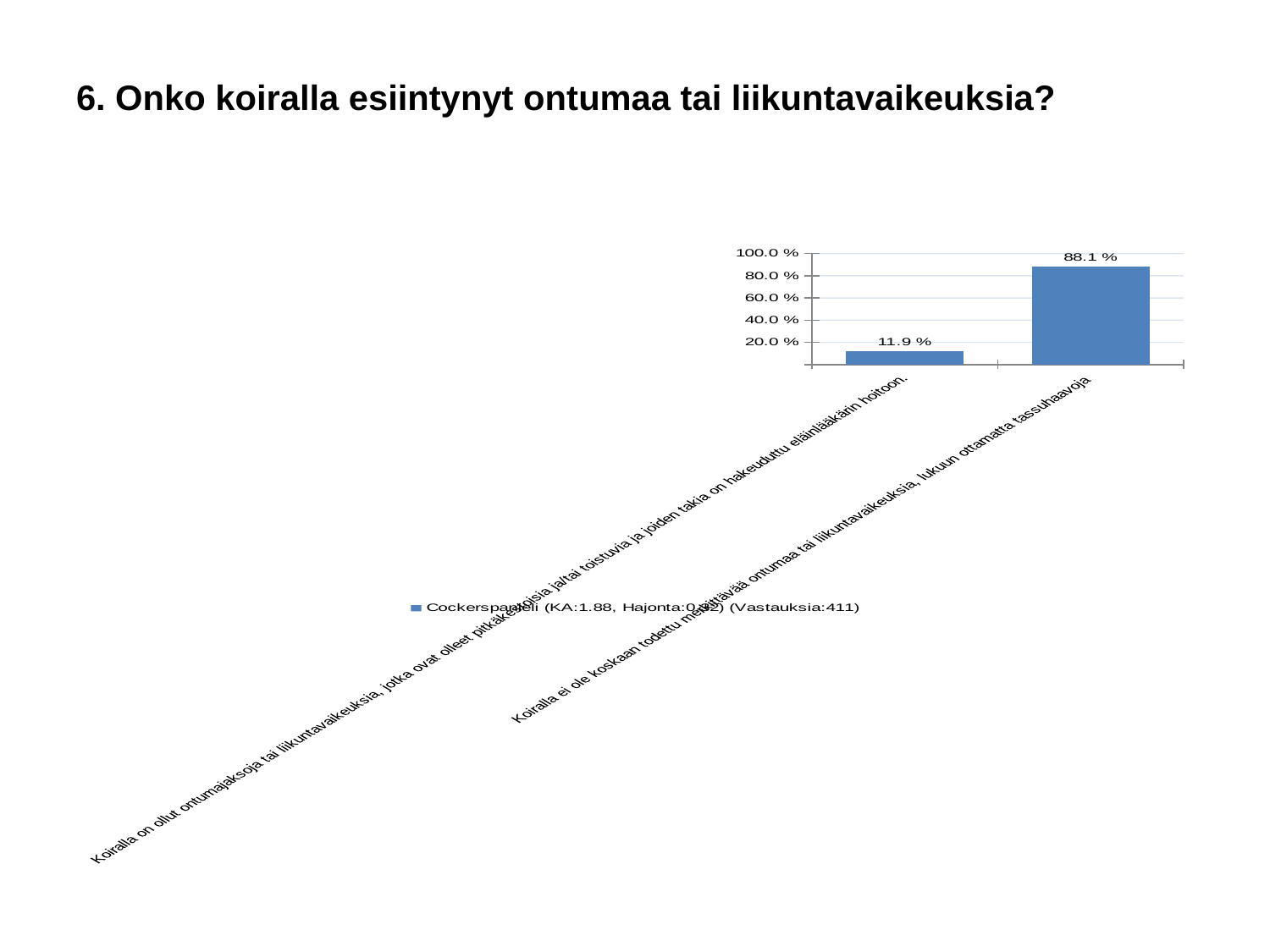
Is the value for the category beginning "Koiralla ei ole koskaan todettu" greater or less than 80.0 %? greater What is the highest tick value shown on the vertical axis? 100.0 % Which category has the highest value? Koiralla ei ole koskaan todettu merkittävää ontumaa tai liikuntavaikeuksia, lukuun ottamatta tassuhaavoja How many categories are plotted in the chart? 2 What value is shown for the category "Koiralla ei ole koskaan todettu merkittävää ontumaa tai liikuntavaikeuksia, lukuun ottamatta tassuhaavoja"? 88.1 % Is the value for the category beginning "Koiralla ei ole koskaan todettu" larger or smaller than the value for the category beginning "Koiralla on ollut ontumajaksoja"? larger Is the value for the category beginning "Koiralla on ollut ontumajaksoja" greater or less than 20.0 %? less What kind of chart is shown on the slide? bar chart Which category has the lowest value? Koiralla on ollut ontumajaksoja tai liikuntavaikeuksia, jotka ovat olleet pitkäkestoisia ja/tai toistuvia ja joiden takia on hakeuduttu eläinlääkärin hoitoon. How many series does the legend list? 1 What is the difference between the two bar values, 88.1 % and 11.9 %? 76.2 % What value is shown for the category beginning "Koiralla on ollut ontumajaksoja tai liikuntavaikeuksia"? 11.9 %